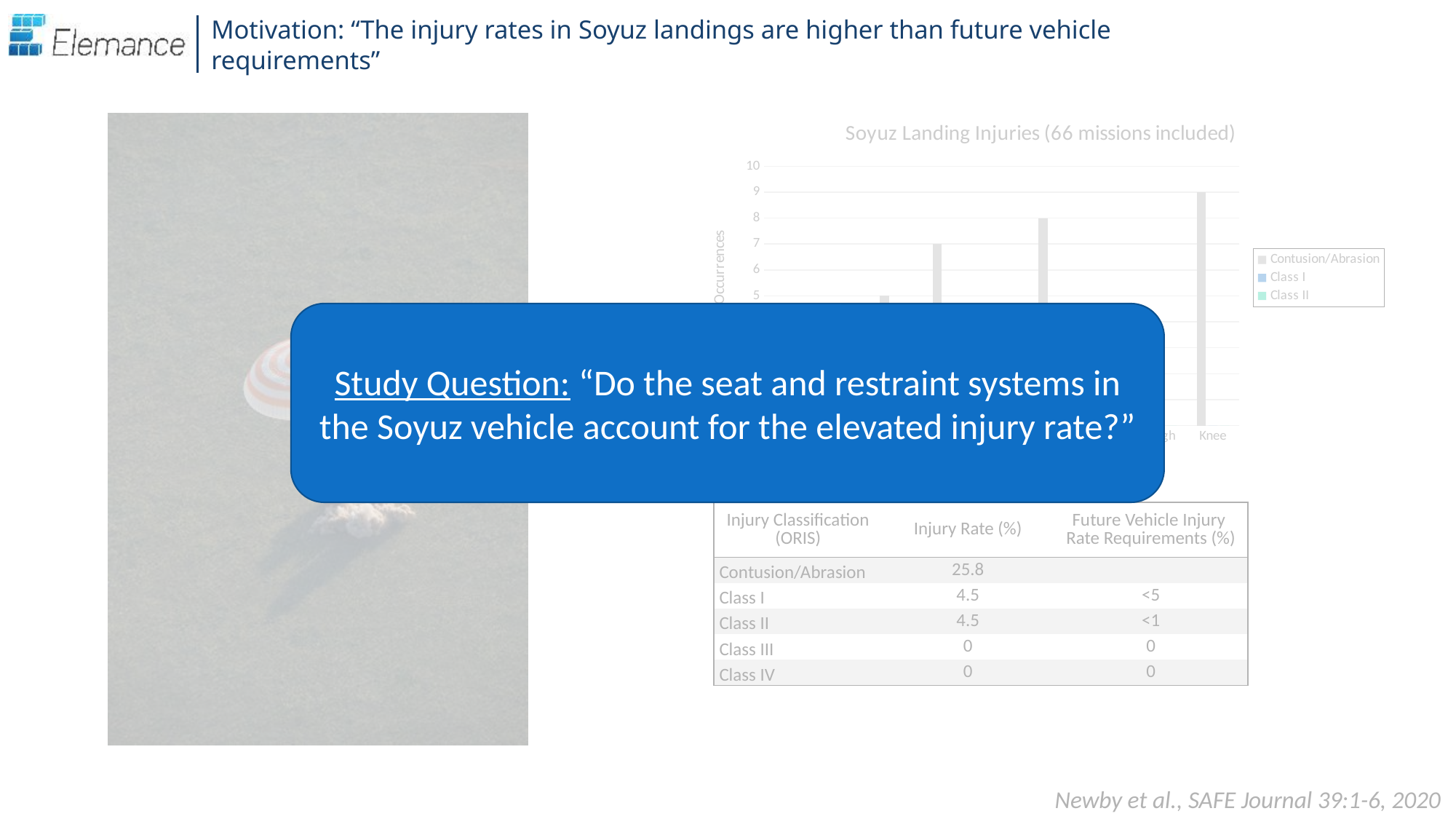
Is the value for Knee in the chart greater or less than 10? less How many series does the chart's legend list? 3 What is the title of the chart on the slide? Soyuz Landing Injuries (66 missions included) What kind of chart is shown on the slide? bar chart Is the value for Knee in the chart greater or less than 8? greater How many occurrences does the chart show for Knee? 9 What are the entries listed in the chart's legend? Contusion/Abrasion, Class I, Class II